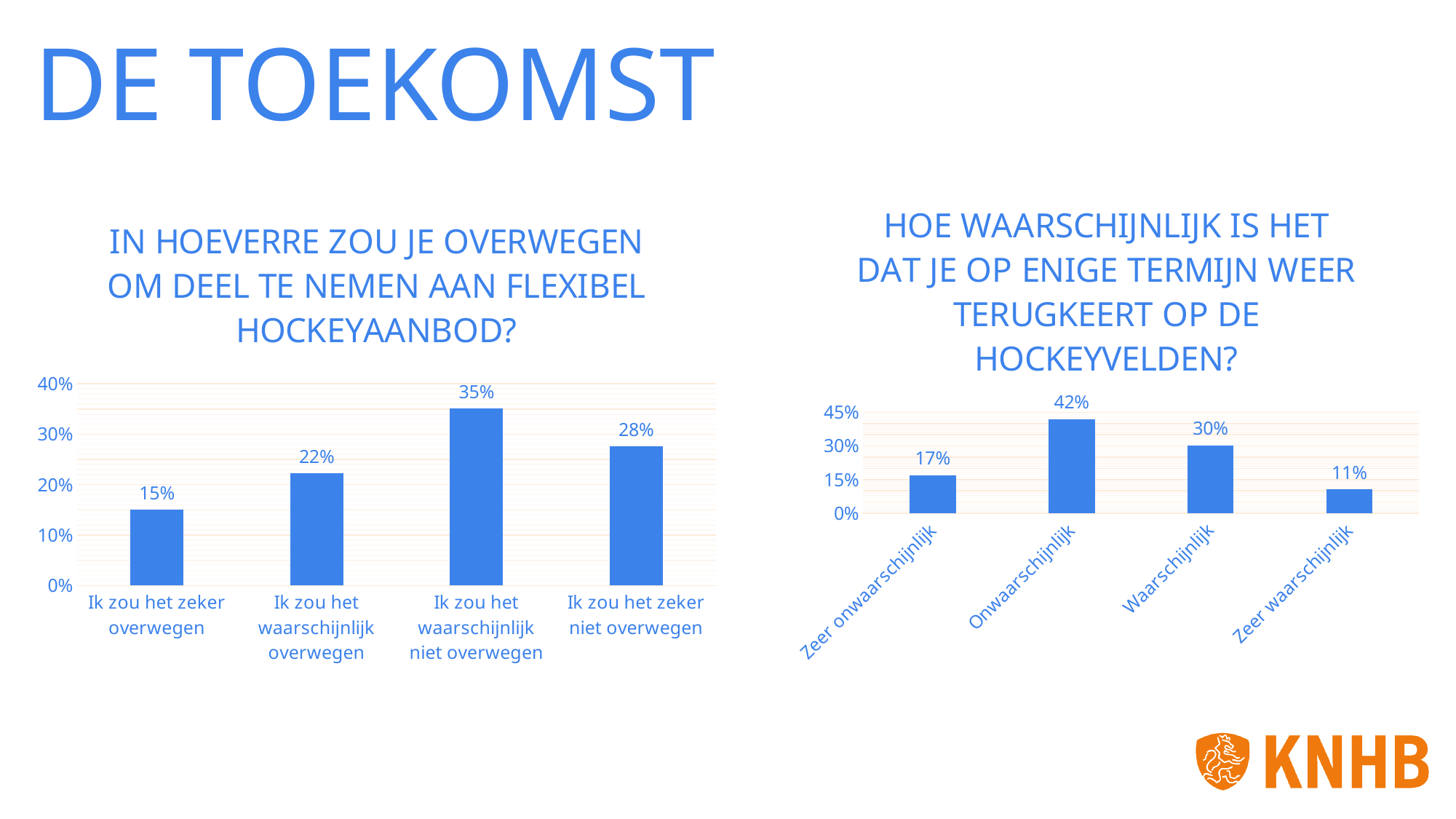
In the left chart (flexibel hockeyaanbod), how many categories are shown? 4 In the left chart (flexibel hockeyaanbod), what is the value for 'Ik zou het zeker overwegen'? 15% In the left chart (flexibel hockeyaanbod), what is the difference between 'Ik zou het zeker niet overwegen' and 'Ik zou het waarschijnlijk overwegen'? 6% In the right chart (terugkeert op de hockeyvelden), what is the value for 'Zeer waarschijnlijk'? 11% In the right chart (terugkeert op de hockeyvelden), which category has the lowest value? Zeer waarschijnlijk In the right chart (terugkeert op de hockeyvelden), which is larger: 'Zeer onwaarschijnlijk' or 'Waarschijnlijk'? Waarschijnlijk In the right chart (terugkeert op de hockeyvelden), what is the value for 'Onwaarschijnlijk'? 42% What kind of chart is the right chart (terugkeert op de hockeyvelden)? Bar chart In the left chart (flexibel hockeyaanbod), what is the value for 'Ik zou het waarschijnlijk niet overwegen'? 35% In the right chart (terugkeert op de hockeyvelden), what is the difference between 'Onwaarschijnlijk' and 'Waarschijnlijk'? 12% In the left chart (flexibel hockeyaanbod), which category has the highest value? Ik zou het waarschijnlijk niet overwegen In the left chart (flexibel hockeyaanbod), which category has the lowest value? Ik zou het zeker overwegen